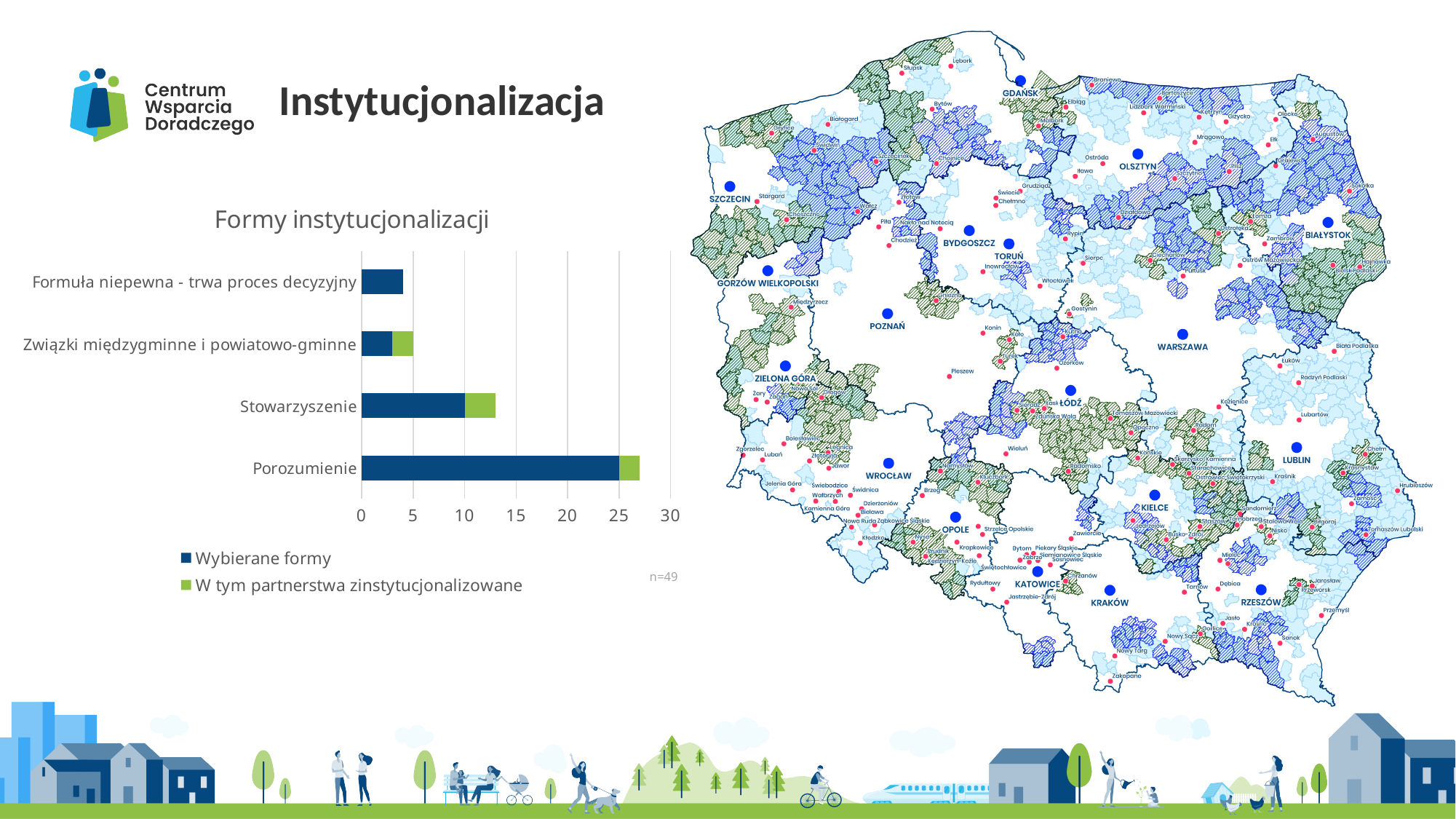
How many categories are shown on the y axis of the 'Formy instytucjonalizacji' chart? 4 Which has a longer bar: Stowarzyszenie or Związki międzygminne i powiatowo-gminne? Stowarzyszenie Which legend entry is shown in green in the 'Formy instytucjonalizacji' chart? W tym partnerstwa zinstytucjonalizowane Is the total bar length for Stowarzyszenie greater or less than 15? less Is the 'Wybierane formy' value for Porozumienie greater or less than 20? greater What kind of chart is 'Formy instytucjonalizacji'? bar chart Is the total bar length for Porozumienie greater or less than 25? greater How many series does the legend of the 'Formy instytucjonalizacji' chart list? 2 Which category has the longest bar in the 'Formy instytucjonalizacji' chart? Porozumienie What is the title of the chart on the left of the slide? Formy instytucjonalizacji What is the 'Wybierane formy' value for Stowarzyszenie? 10